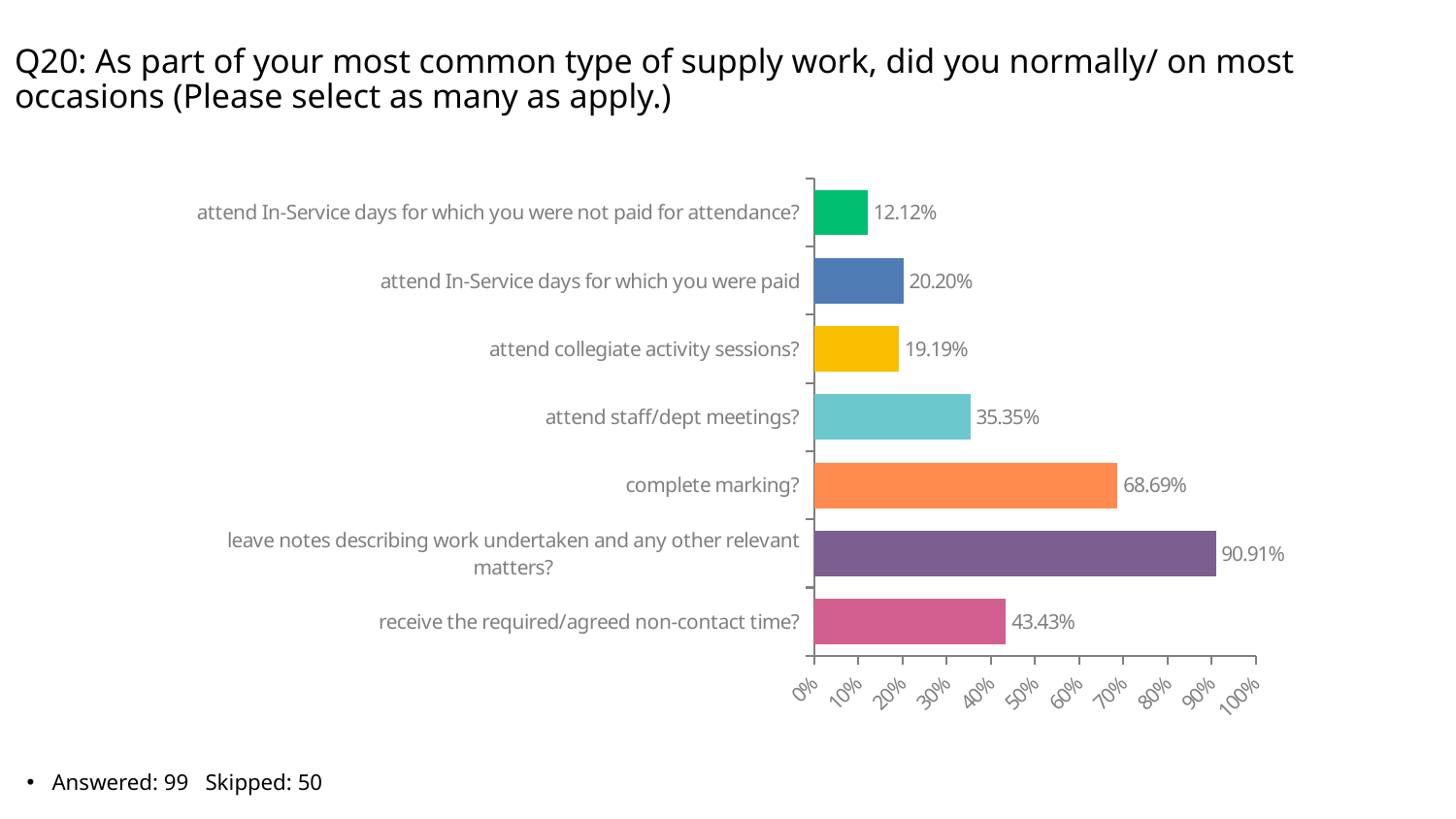
What is the difference between the value for 'complete marking?' and the value for 'receive the required/agreed non-contact time?' 25.26% What kind of chart is shown on the slide? bar chart How many categories are shown in the chart? 7 What percentage of respondents said they complete marking? 68.69% Which is larger: the value for 'attend In-Service days for which you were paid' or the value for 'attend collegiate activity sessions?' attend In-Service days for which you were paid Is the value for 'receive the required/agreed non-contact time?' greater or less than 40%? greater Which category has the lowest value? attend In-Service days for which you were not paid for attendance? What percentage of respondents attended In-Service days for which they were not paid for attendance? 12.12% Which category has the highest value? leave notes describing work undertaken and any other relevant matters? What is the value for 'leave notes describing work undertaken and any other relevant matters?' 90.91% How many respondents answered the question according to the slide? 99 What is the value for 'attend staff/dept meetings?' 35.35%